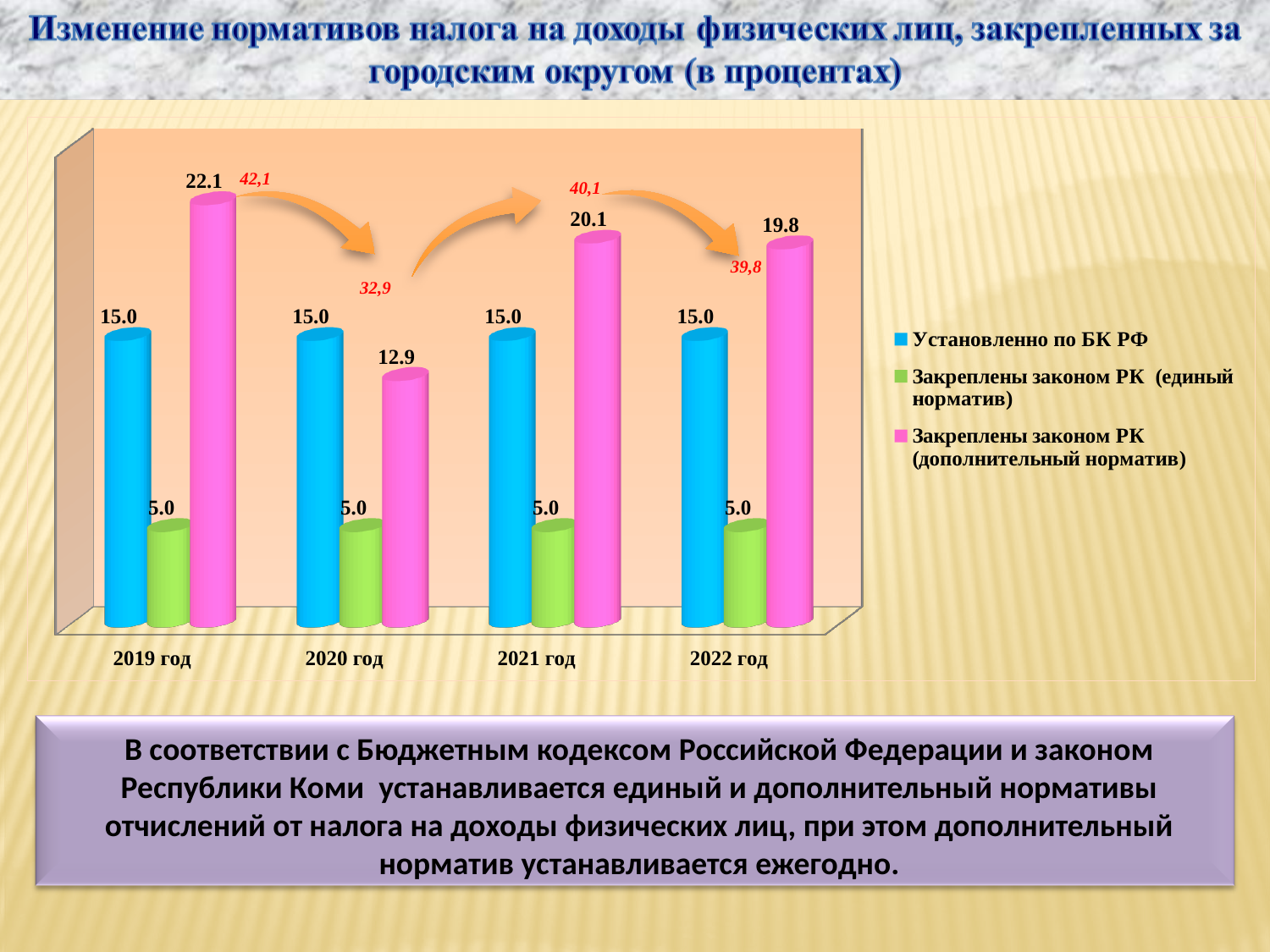
What is the value of the 'Закреплены законом РК (дополнительный норматив)' series for 2019 год? 22.1 How many years (categories) are shown on the x axis? 4 What total is annotated in red above the bars for 2022 год? 39,8 What is the difference between the 'дополнительный норматив' values for 2019 год and 2020 год? 9.2 What is the value of the 'Установленно по БК РФ' series for 2021 год? 15.0 What is the value of the 'Закреплены законом РК (дополнительный норматив)' series for 2020 год? 12.9 Which is larger in 2021 год: the 'Установленно по БК РФ' value or the 'дополнительный норматив' value? Закреплены законом РК (дополнительный норматив) What is the value of the 'Закреплены законом РК (единый норматив)' series for 2022 год? 5.0 In which year is the 'Закреплены законом РК (дополнительный норматив)' value the highest? 2019 год What type of chart is shown on the slide? bar chart In which year is the 'Закреплены законом РК (дополнительный норматив)' value the lowest? 2020 год How many series does the legend list? 3